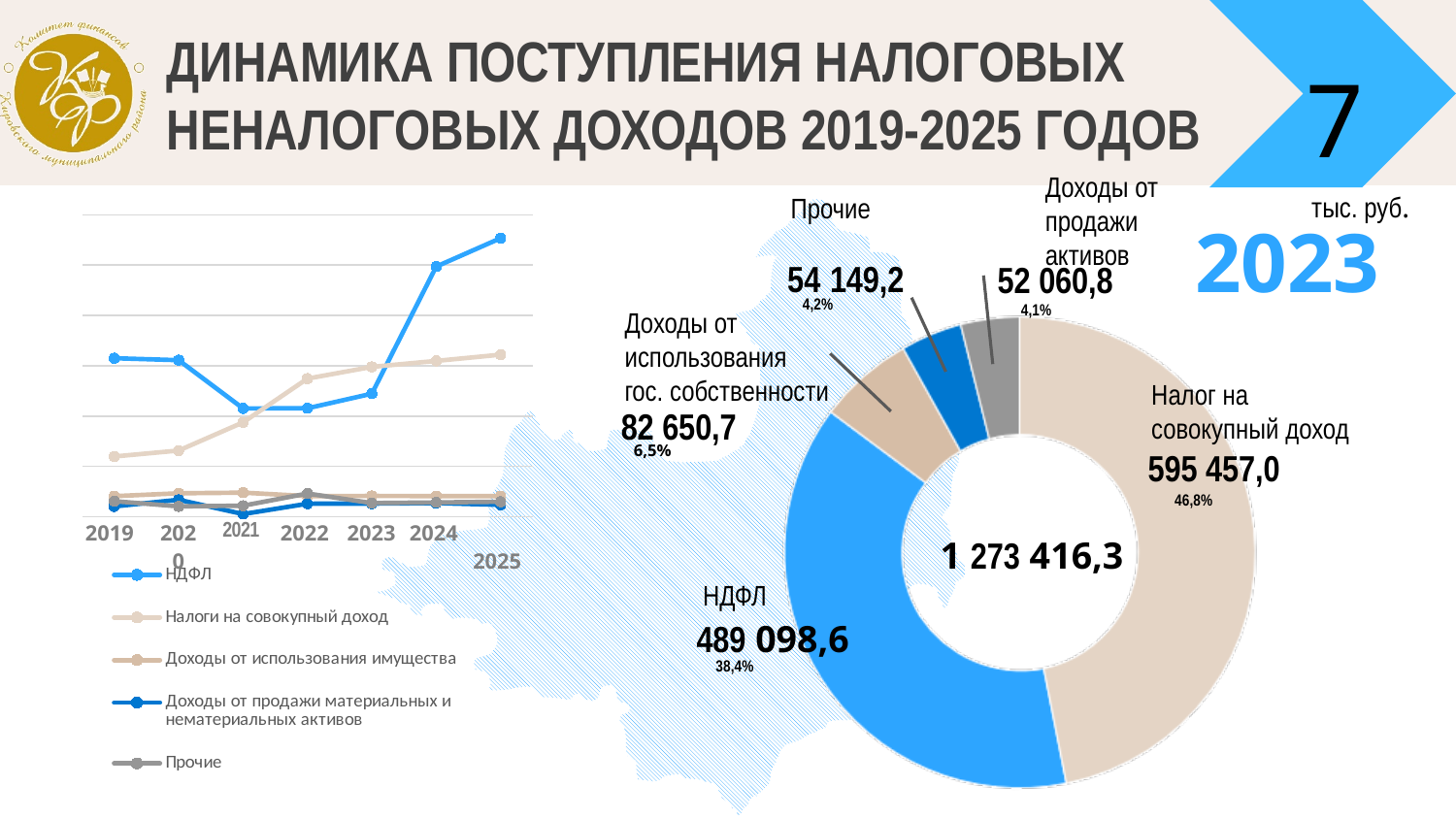
In the doughnut chart on the right, which is larger: Прочие or Доходы от продажи активов? Прочие In the doughnut chart on the right, what is the value for Налог на совокупный доход? 595 457,0 In the doughnut chart on the right, which category has the smallest value? Доходы от продажи активов In the doughnut chart on the right, what is the total shown in the centre? 1 273 416,3 In the doughnut chart on the right, what share does Доходы от использования гос. собственности have? 6,5% In the doughnut chart on the right, which category has the largest value? Налог на совокупный доход In the doughnut chart on the right, what is the value for НДФЛ? 489 098,6 In the doughnut chart on the right, how many categories are shown? 5 In the line chart on the left, how many series does the legend list? 5 In the line chart on the left, which series has the highest value in 2025? НДФЛ In the line chart on the left, which series is higher in 2022: НДФЛ or Налоги на совокупный доход? Налоги на совокупный доход In the doughnut chart on the right, what is the difference between Налог на совокупный доход and НДФЛ? 106 358,4